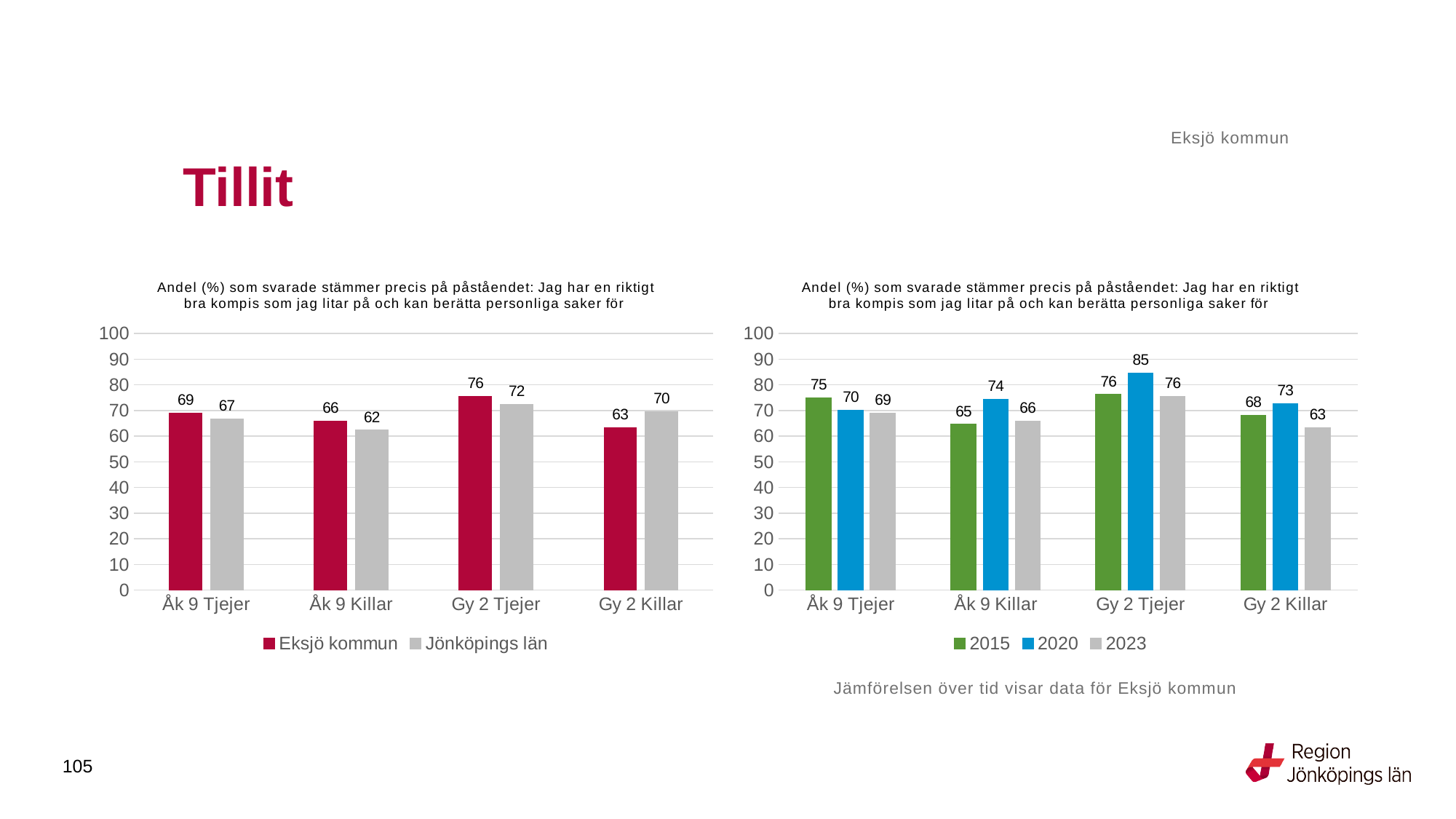
In the right chart, what is the value for 2020 for Gy 2 Tjejer? 85 How many categories are shown on the x axis of the right chart? 4 In the left chart, what is the difference between Eksjö kommun and Jönköpings län for Åk 9 Killar? 4 In the left chart, what is the value for Eksjö kommun for Gy 2 Tjejer? 76 What kind of chart is the right chart? Bar chart How many series does the legend of the left chart list? 2 In the right chart, what is the value for 2023 for Gy 2 Killar? 63 In the right chart, what is the difference between 2020 and 2023 for Gy 2 Killar? 10 In the left chart, what is the value for Jönköpings län for Åk 9 Killar? 62 In the left chart, which category has the lowest value for Eksjö kommun? Gy 2 Killar In the right chart, which category has the highest value for 2020? Gy 2 Tjejer In the left chart, which is larger for Gy 2 Killar: Eksjö kommun or Jönköpings län? Jönköpings län